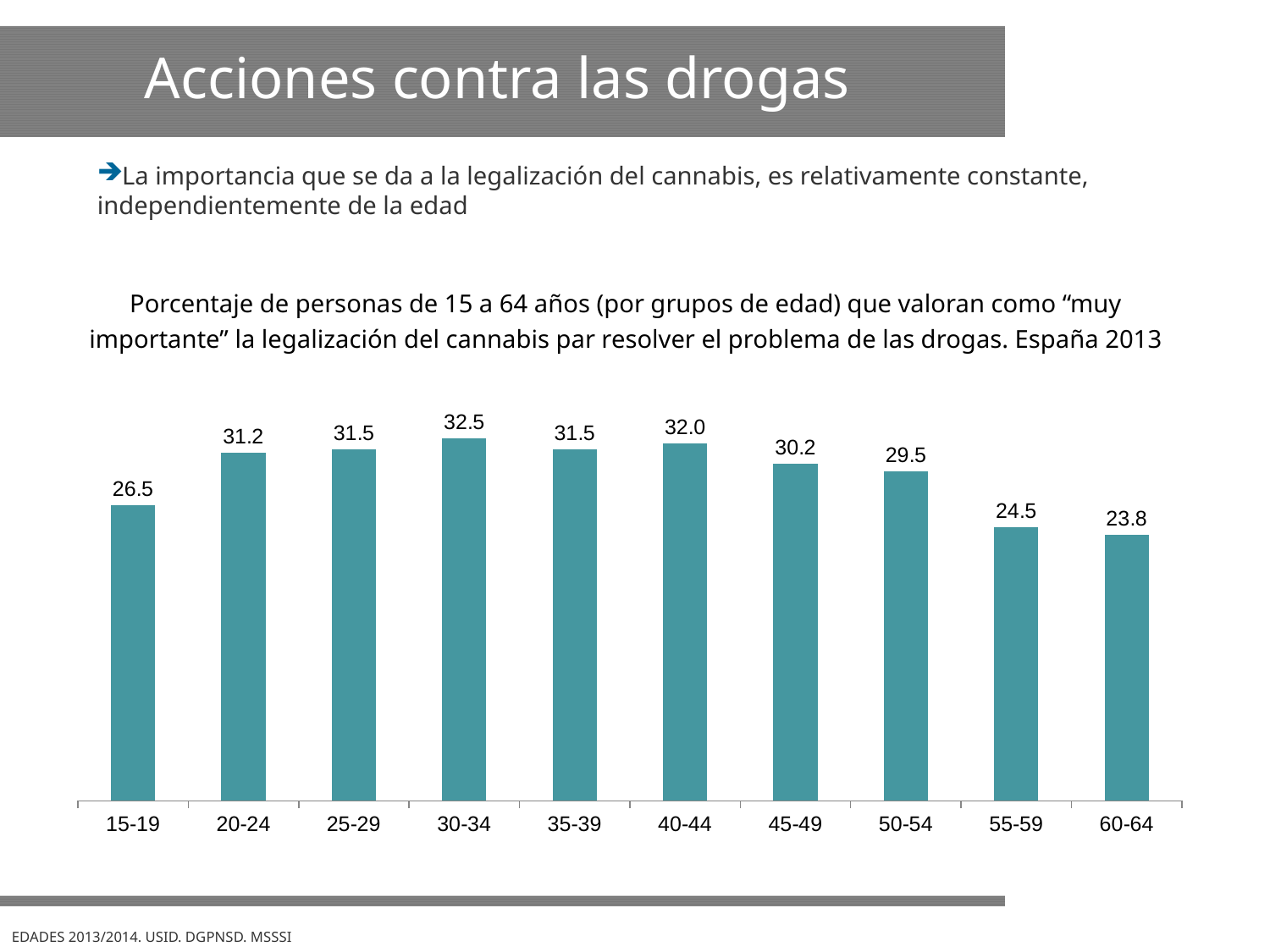
Do the values rise or fall from the 40-44 group to the 60-64 group? Fall What is the value for the 15-19 age group? 26.5 Which has a larger value, 45-49 or 55-59? 45-49 What is the difference between the values for 20-24 and 15-19? 4.7 What is the value for the 40-44 age group? 32.0 How many age groups are shown in the chart? 10 What is the value for the 60-64 age group? 23.8 What kind of chart is shown on the slide? Bar chart What is the difference between the values for 30-34 and 60-64? 8.7 Which age group has the lowest value? 60-64 Which age group has the highest value? 30-34 Which has a larger value, 15-19 or 50-54? 50-54